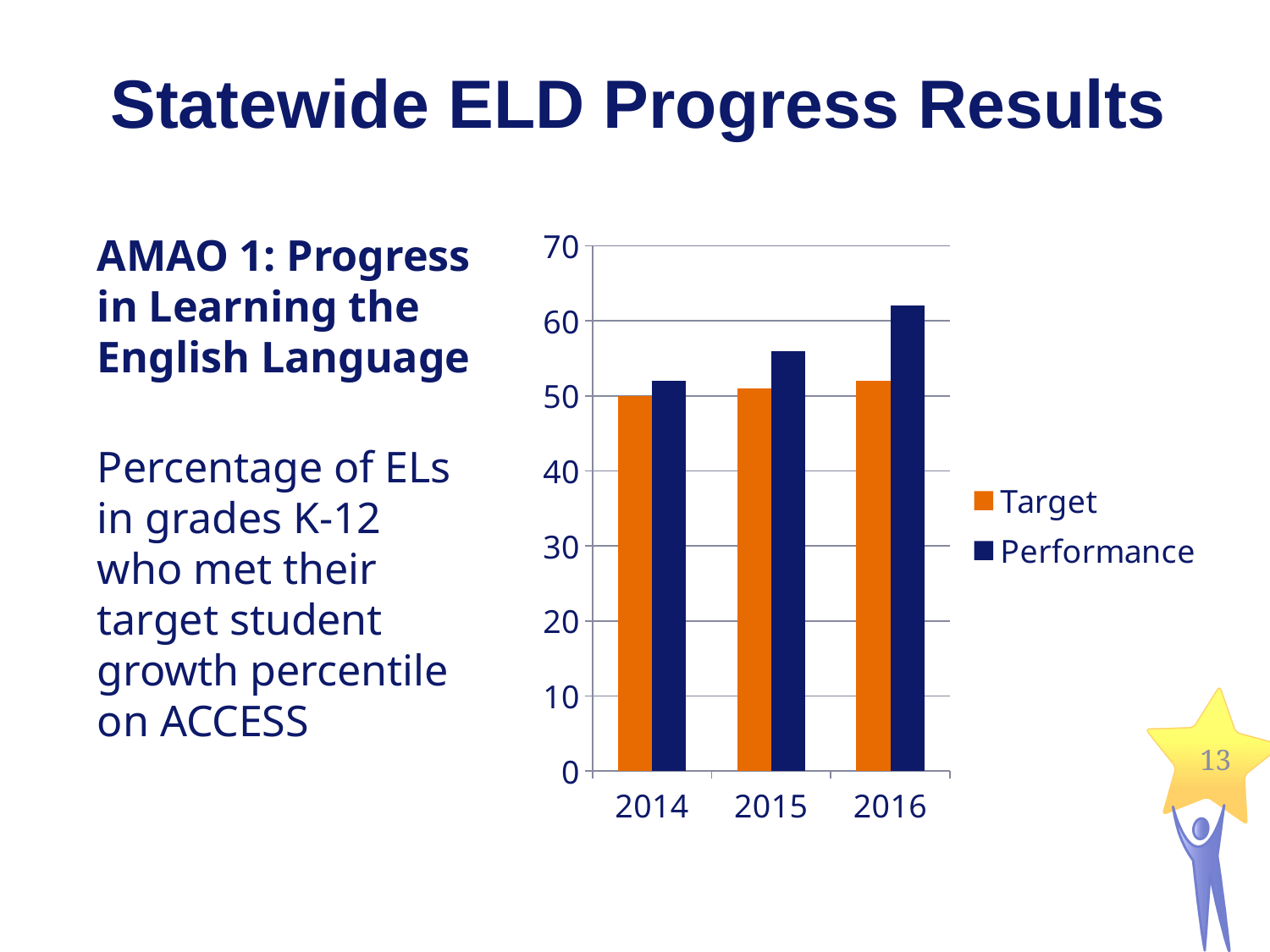
Which colour represents the Target series in the legend? orange Is the Target value for 2016 greater or less than 60? less Is the Performance value for 2016 greater or less than 60? greater Do the Performance values rise or fall from 2014 to 2016? rise How many series does the legend list? 2 What kind of chart is shown on the slide? bar chart How many years are shown on the x axis? 3 Which years are shown on the x axis? 2014, 2015, 2016 What is the Target value for 2014? 50 Is the Performance value for 2015 greater or less than 50? greater In 2016, which is larger, Target or Performance? Performance In which year is the Performance value highest? 2016